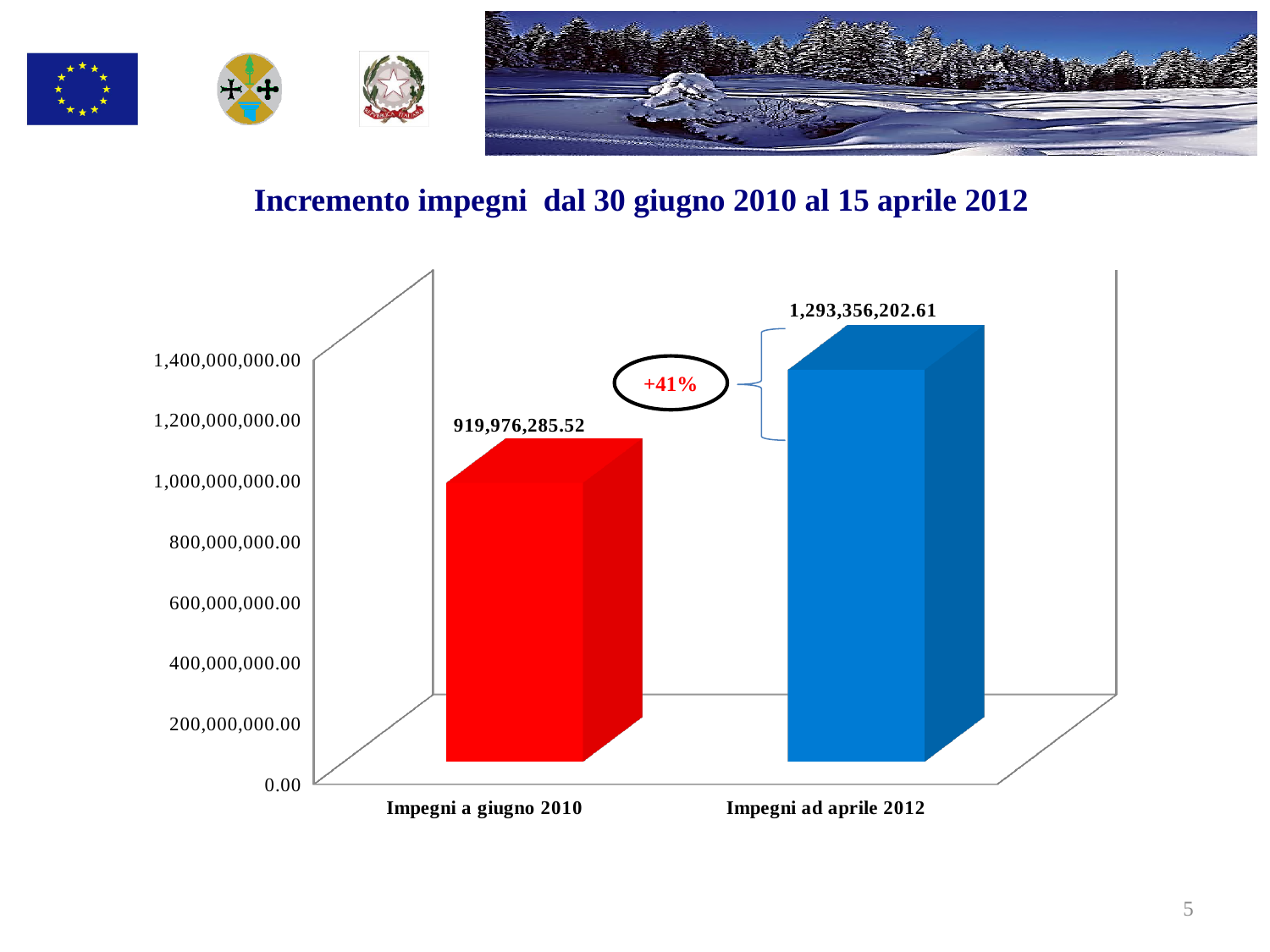
What kind of chart is shown on the slide? bar chart What is the difference between the value for Impegni ad aprile 2012 and the value for Impegni a giugno 2010? 373,379,917.09 Is the value for Impegni ad aprile 2012 greater or less than 1,200,000,000.00? greater Which category has the lowest value? Impegni a giugno 2010 Which category has the highest value? Impegni ad aprile 2012 How many categories are shown on the chart? 2 What percentage increase is annotated between the two bars? +41% What is the value for Impegni a giugno 2010? 919,976,285.52 Is the value for Impegni a giugno 2010 greater or less than 800,000,000.00? greater Which is larger, the value for Impegni a giugno 2010 or the value for Impegni ad aprile 2012? Impegni ad aprile 2012 What is the value for Impegni ad aprile 2012? 1,293,356,202.61 Do the values rise or fall from Impegni a giugno 2010 to Impegni ad aprile 2012? rise